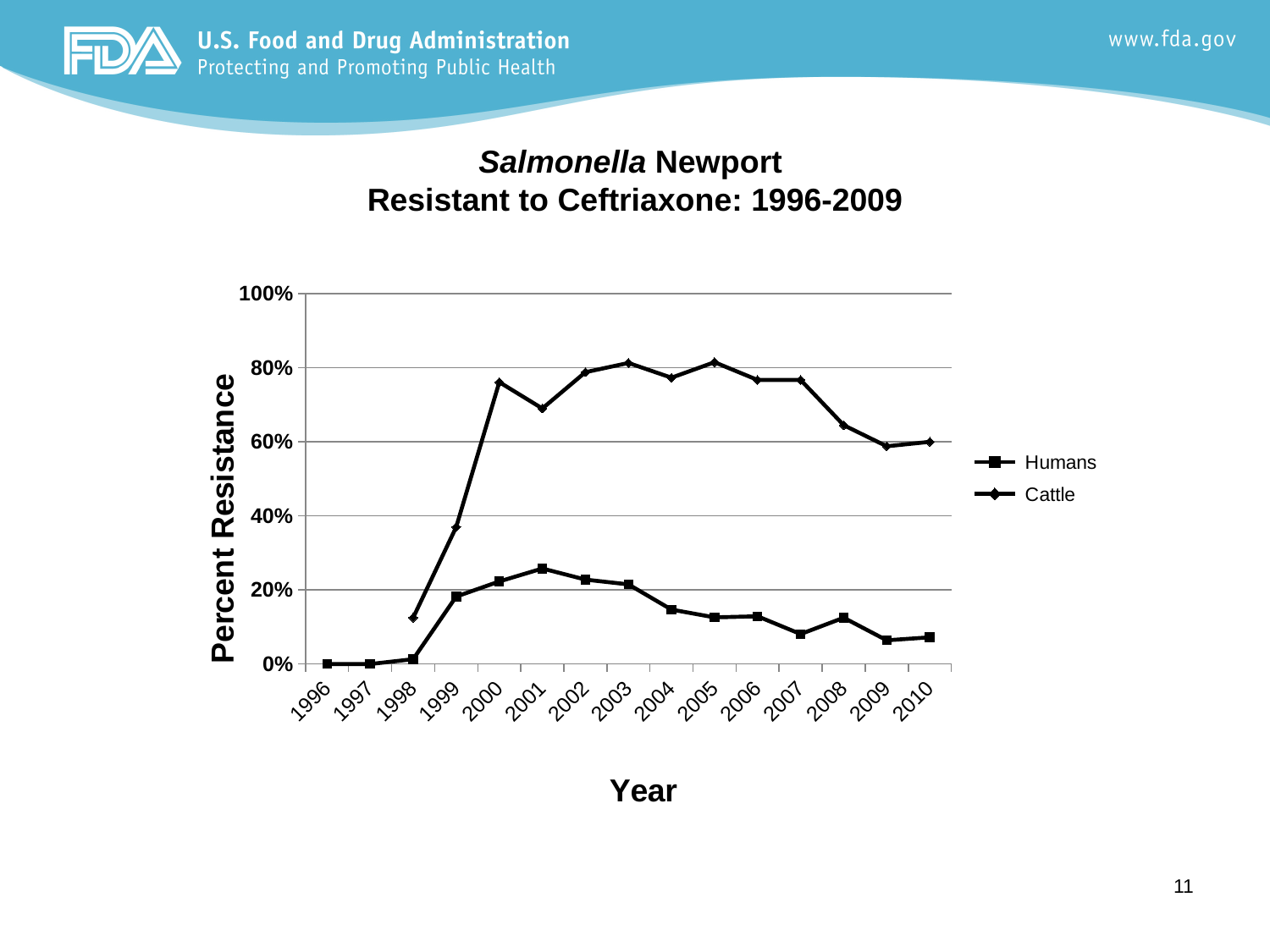
Is the value for Cattle in 2009 greater or less than 80%? less Which series has the higher value in 2005, Humans or Cattle? Cattle Is the value for Humans in 2004 greater or less than 20%? less What is the label of the y axis? Percent Resistance How many series does the legend list? 2 What kind of chart is shown on the slide? Line chart In which year does the Humans series reach its highest value? 2001 How many years are shown on the x axis? 15 Which series is plotted with square markers? Humans In which year is the Cattle series at its lowest value? 1998 Is the value for Cattle in 2000 greater or less than 60%? greater Does the Cattle series rise or fall from 1998 to 2000? Rise